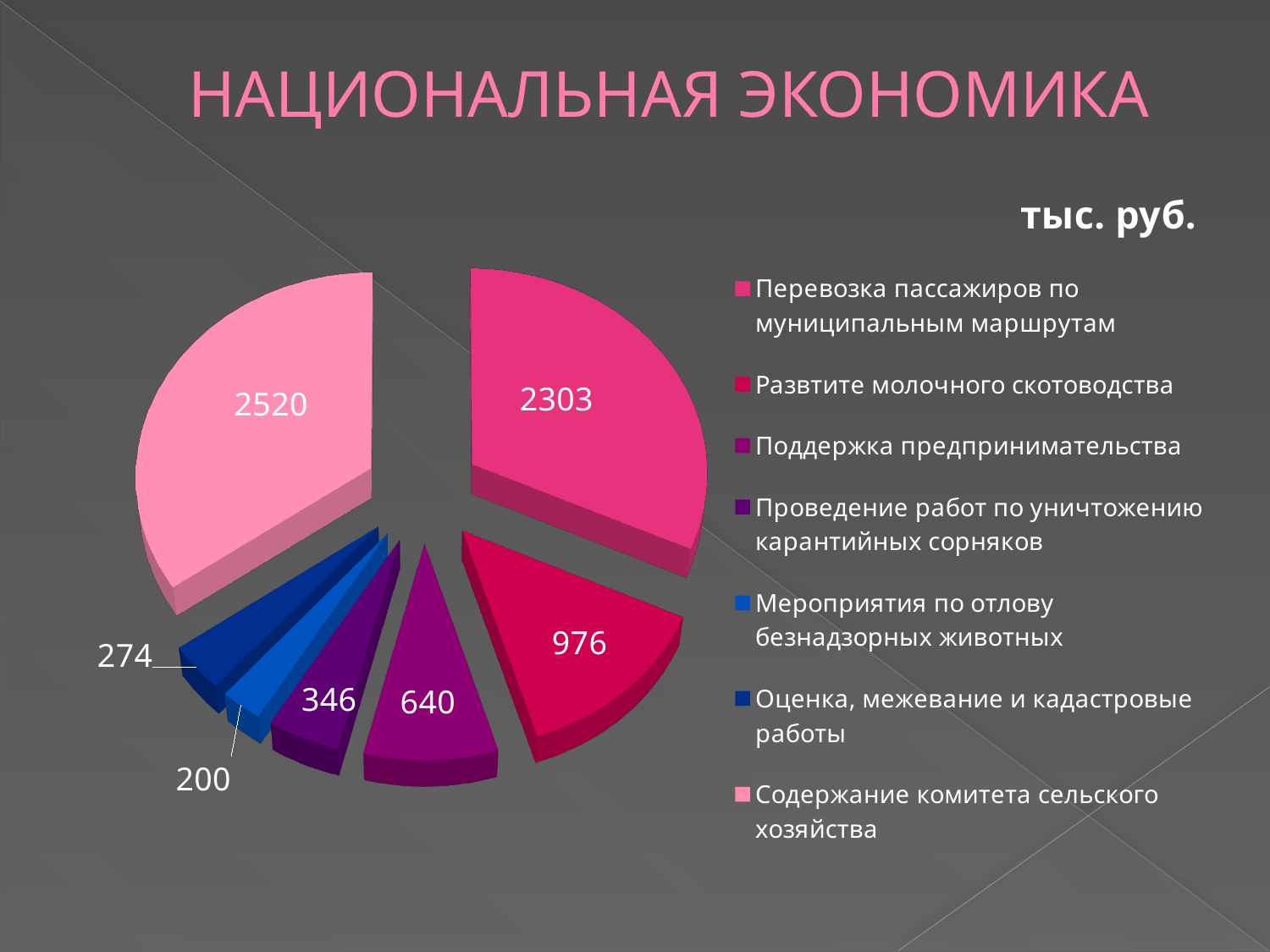
What is the value for Оценка, межевание и кадастровые работы? 274 What type of chart is shown on the slide? Pie chart Which category has the smallest slice of the pie? Мероприятия по отлову безнадзорных животных What is the value for Содержание комитета сельского хозяйства? 2520 What is the value for Мероприятия по отлову безнадзорных животных? 200 How many categories does the legend list? 7 In what units are the values on the chart given? тыс. руб. Which category has the largest slice of the pie? Содержание комитета сельского хозяйства What is the difference between the values for Поддержка предпринимательства and Проведение работ по уничтожению карантийных сорняков? 294 Which is larger: the value for Развтите молочного скотоводства or the value for Поддержка предпринимательства? Развтите молочного скотоводства What is the value for Перевозка пассажиров по муниципальным маршрутам? 2303 What is the value for Развтите молочного скотоводства? 976